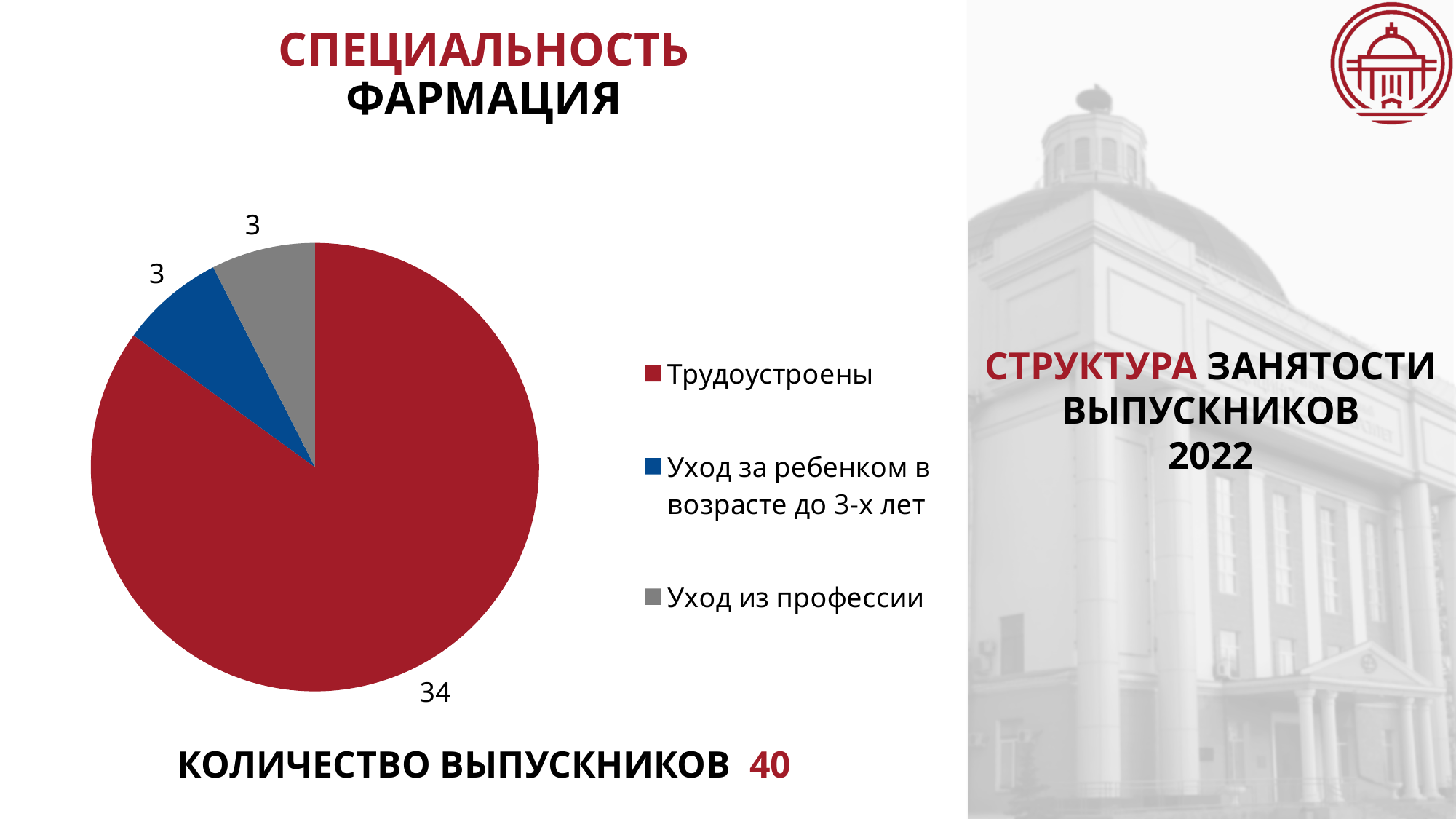
What colour is the "Уход за ребенком в возрасте до 3-х лет" slice? blue What kind of chart is shown on the slide? pie chart What is the total of all slices in the pie chart? 40 What share of the pie does the "Трудоустроены" slice represent? 85% How many slices does the pie chart have? 3 What value is shown for the "Уход за ребенком в возрасте до 3-х лет" slice? 3 What is the difference between the "Трудоустроены" value and the "Уход из профессии" value? 31 How many entries does the legend list? 3 How many graduates are in the "Трудоустроены" slice of the pie chart? 34 Which category has the largest slice of the pie chart? Трудоустроены Which is larger: the "Трудоустроены" slice or the "Уход за ребенком в возрасте до 3-х лет" slice? Трудоустроены What value is shown for the "Уход из профессии" slice? 3